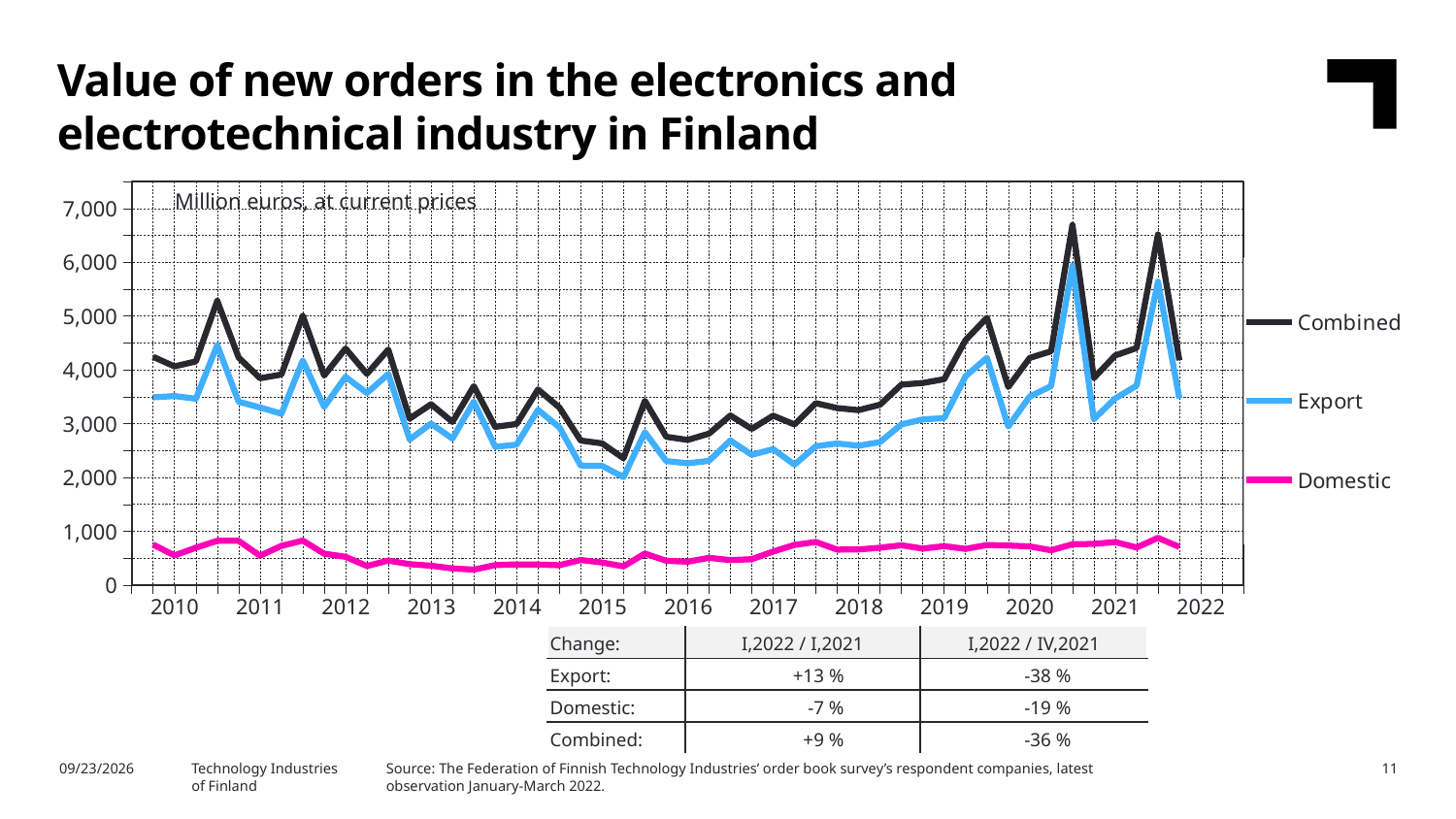
Which series is larger in 2018, Export or Domestic? Export Does the Combined series generally rise or fall between 2010 and 2015? fall Is the value for Export at the start of 2015 greater or less than 3,000? less Which series has the lowest values across the whole chart? Domestic Is the peak value of the Combined series in 2020 greater or less than 6,000? greater Which series has the highest values across the whole chart? Combined How many series does the legend list? 3 Is the value for Domestic in 2015 greater or less than 1,000? less What are the three series named in the legend? Combined, Export, Domestic In what unit are the values on the chart expressed? Million euros, at current prices What kind of chart is shown on the slide? line chart According to the table, what is the change in Export orders for I,2022 / I,2021? +13 %